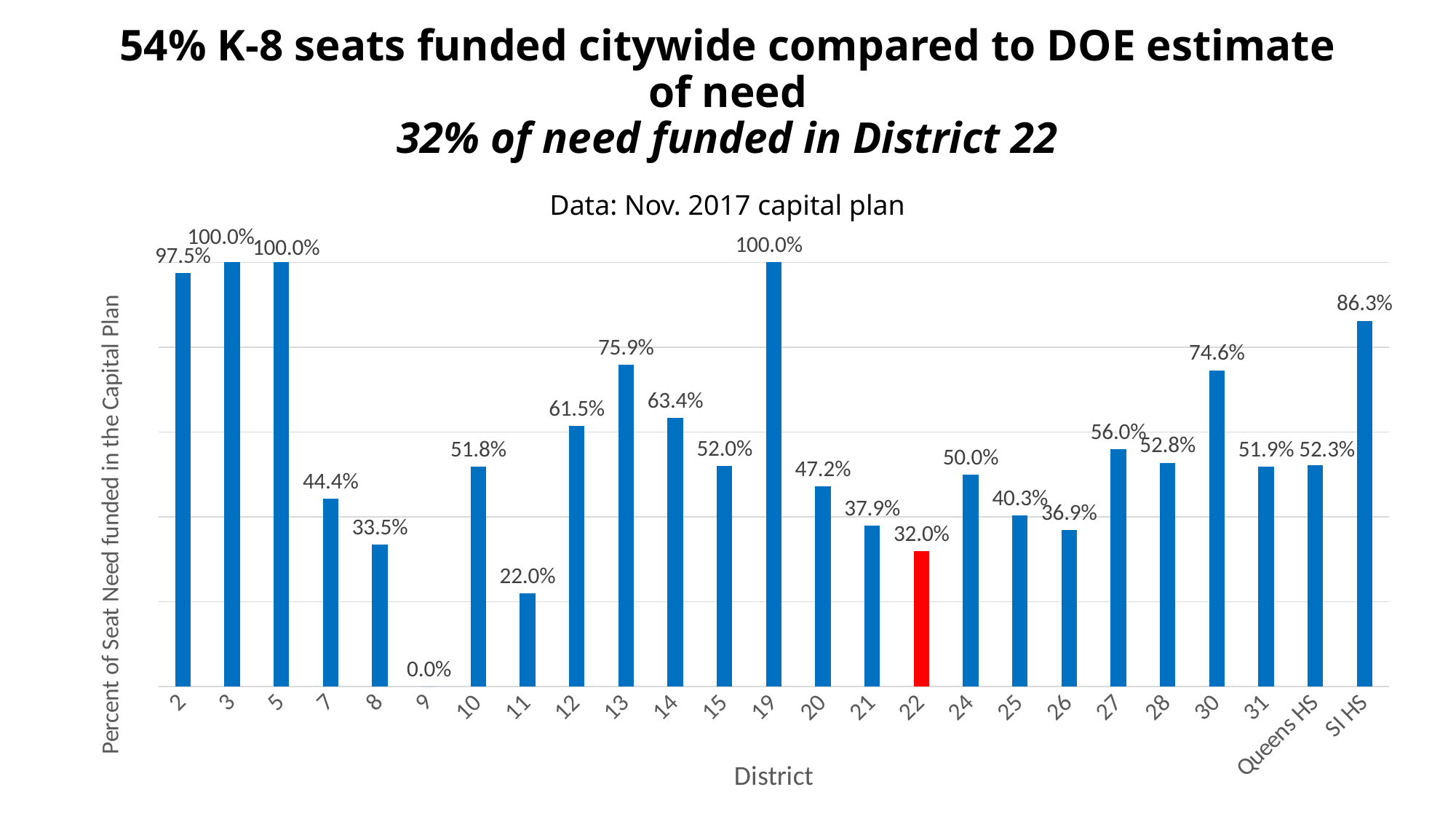
Which is larger, the value for District 12 or the value for District 14? District 14 Which bar is coloured red instead of blue? District 22 Which is larger, the value for District 8 or the value for District 25? District 25 What is the value for Queens HS? 52.3% Which district has the lowest percent of seat need funded? 9 How many districts are shown on the x axis? 25 What is the value for District 22? 32.0% What is the value for SI HS? 86.3% What is the value for District 11? 22.0% What is the difference between the values for District 30 and District 31? 22.7% What is the difference between the values for District 13 and District 22? 43.9% What kind of chart is shown on the slide? bar chart